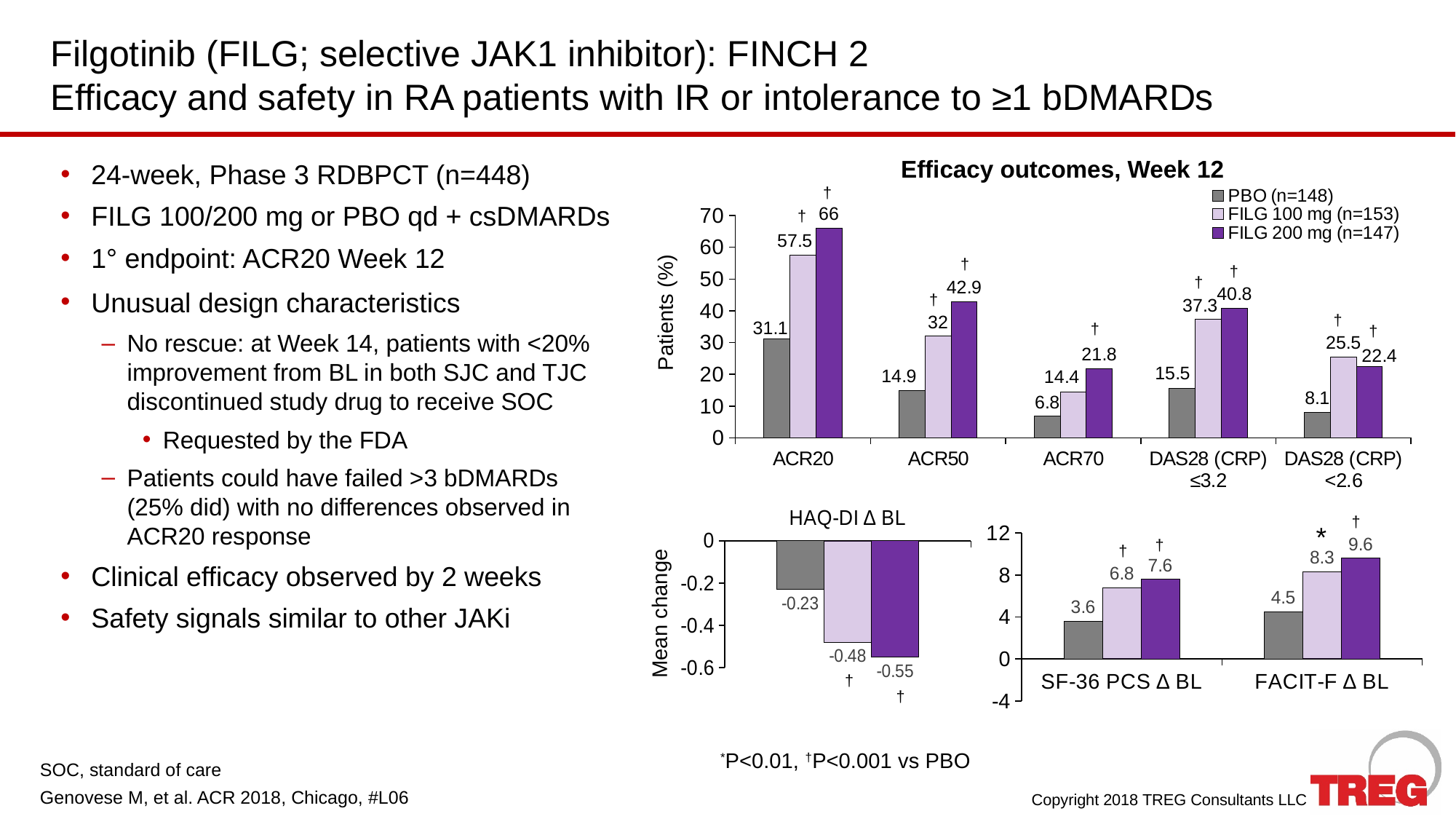
What kind of chart is the 'Efficacy outcomes, Week 12' chart? Bar chart In the 'HAQ-DI Δ BL' chart, what is the difference between the FILG 100 mg and PBO mean changes? 0.25 In the bottom-right chart, which series has the highest SF-36 PCS Δ BL value? FILG 200 mg (n=147) In the 'HAQ-DI Δ BL' chart, what is the mean change for FILG 200 mg? -0.55 In the 'Efficacy outcomes, Week 12' chart, which is larger for DAS28 (CRP) <2.6: FILG 100 mg or FILG 200 mg? FILG 100 mg How many categories are shown on the x axis of the 'Efficacy outcomes, Week 12' chart? 5 In the 'Efficacy outcomes, Week 12' chart, which category has the lowest PBO (n=148) value? ACR70 In the 'Efficacy outcomes, Week 12' chart, what is the ACR50 response for PBO (n=148)? 14.9 In the 'Efficacy outcomes, Week 12' chart, what is the ACR20 response for FILG 200 mg (n=147)? 66 In the 'Efficacy outcomes, Week 12' chart, what is the difference between the FILG 200 mg and PBO values for ACR20? 34.9 In the bottom-right chart, what is the FACIT-F Δ BL value for FILG 100 mg? 8.3 How many series does the legend of the 'Efficacy outcomes, Week 12' chart list? 3